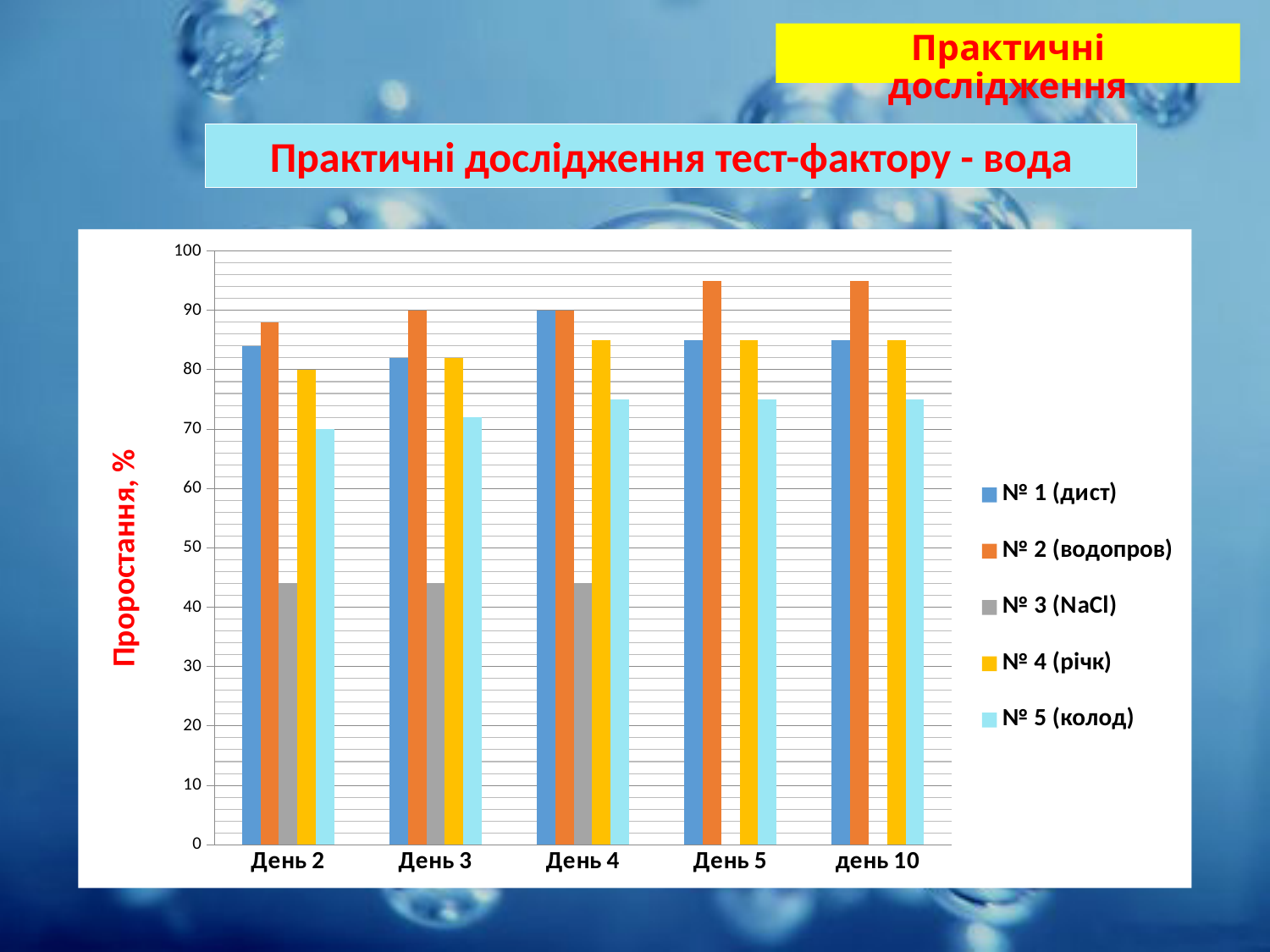
How many categories are shown on the x axis? 5 Is the value for № 3 (NaCl) on День 3 greater or less than 50? less Which series has the lowest value on День 2? № 3 (NaCl) What kind of chart is shown on the slide? bar chart How many series does the legend list? 5 Does the value for № 2 (водопров) rise or fall from День 2 to день 10? rise Which is larger on День 4: № 1 (дист) or № 5 (колод)? № 1 (дист) What is the title of the vertical axis? Проростання, % Is the value for № 5 (колод) on День 2 greater or less than 80? less Which series is shown in grey? № 3 (NaCl) Which series has the highest value on День 5? № 2 (водопров) Is the value for № 2 (водопров) on день 10 greater or less than 90? greater